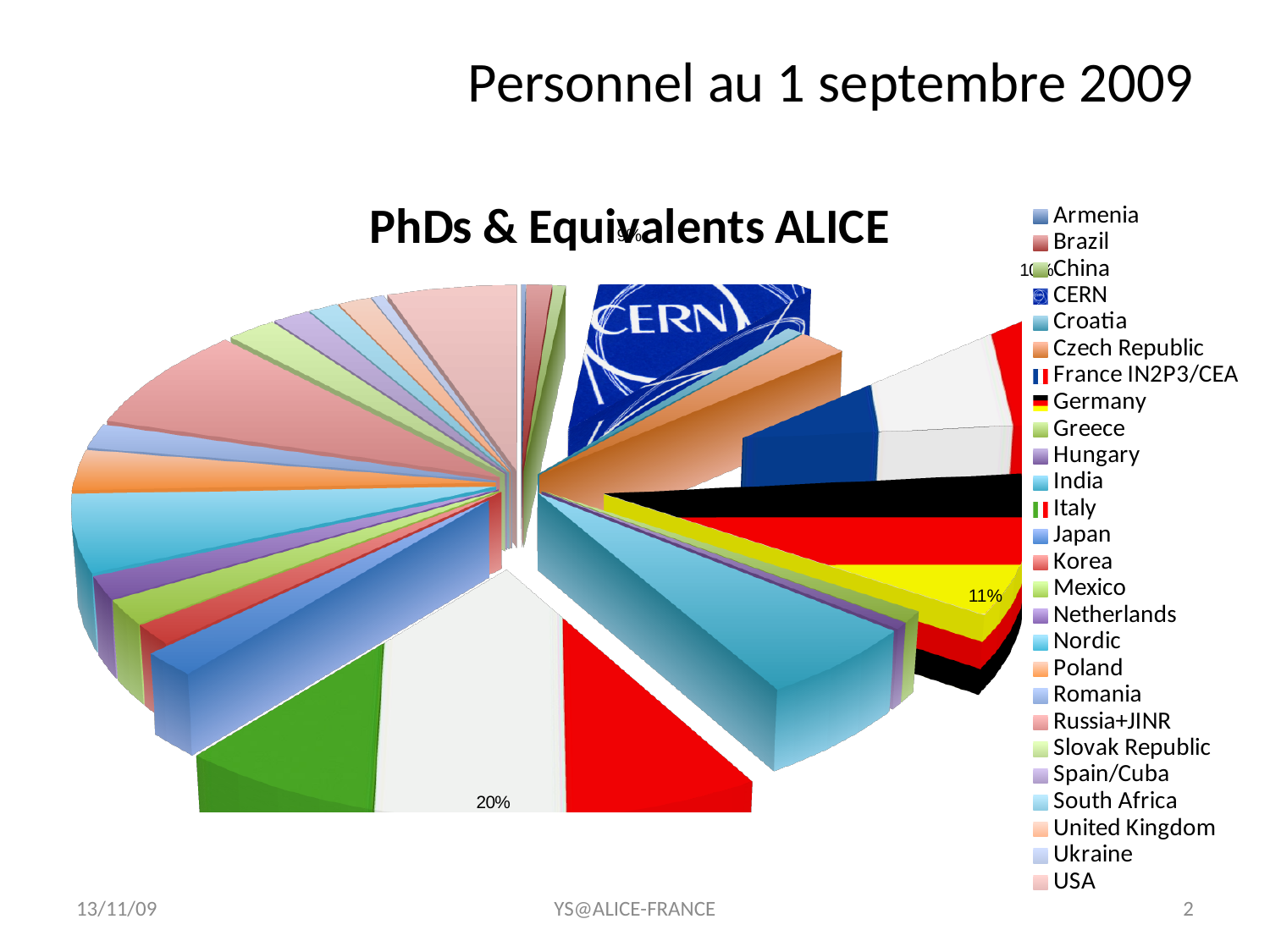
How many entries does the chart's legend list? 26 Which category has the largest slice of the pie? Italy What is the title of the chart? PhDs & Equivalents ALICE Is Germany's share of the pie greater or less than 15%? less Which slice is larger, Italy or Germany? Italy What share of the pie does Germany hold? 11% Is Italy's share of the pie greater or less than 15%? greater By how many percentage points does Italy's share exceed Germany's share? 9 percentage points What kind of chart is shown on the slide? pie chart Which category is listed first in the legend? Armenia What share of the pie does Italy hold? 20%